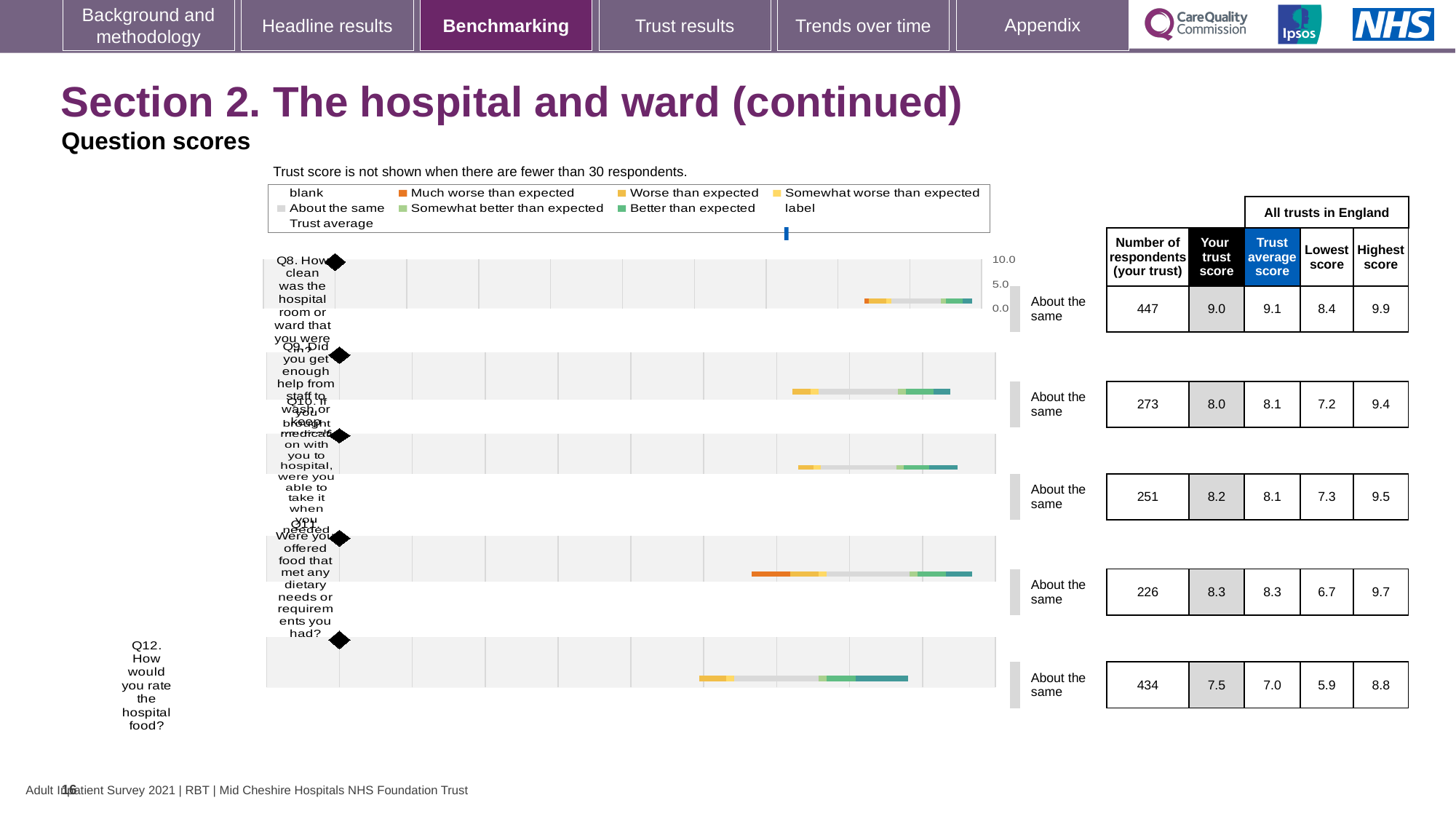
For Q11, what is the difference between the highest score and the lowest score across all trusts in England? 3.0 What benchmark category label is shown next to every question in the chart? About the same For Q10, which is larger: 'Your trust score' or the 'Trust average score'? Your trust score What is the number of respondents for Q12 (how would you rate the hospital food)? 434 How many questions (Q8 to Q12) are plotted in the chart? 5 What kind of chart is used to show the question scores on this slide? bar chart For Q12, what is the difference between 'Your trust score' and the 'Trust average score'? 0.5 What is the 'Highest score' across all trusts in England for Q11? 9.7 Which question has the lowest 'Your trust score'? Q12 What is the 'Your trust score' for Q8 (how clean was the hospital room or ward)? 9.0 What is the 'Lowest score' across all trusts in England for Q9? 7.2 Which question has the highest 'Your trust score'? Q8